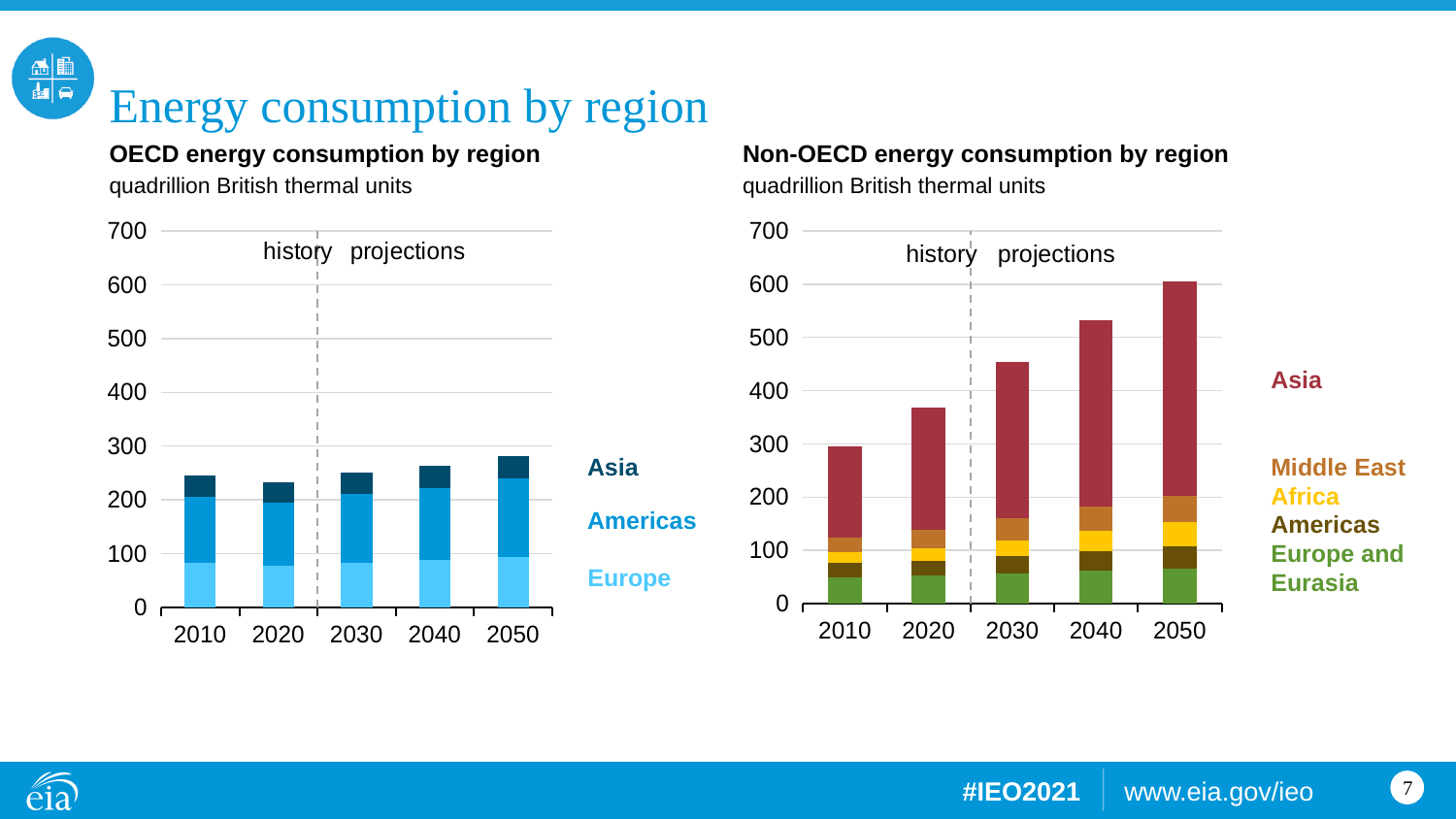
What unit is used on the y axis of both charts? quadrillion British thermal units In the OECD energy consumption by region chart, is the total for 2050 greater or less than 300? less What type of chart is the OECD energy consumption by region chart? stacked bar chart In the Non-OECD energy consumption by region chart, which year has the lowest total consumption? 2010 How many series does the legend of the OECD energy consumption by region chart list? 3 How many years are shown on the x axis of the Non-OECD energy consumption by region chart? 5 How many series does the legend of the Non-OECD energy consumption by region chart list? 5 In the Non-OECD energy consumption by region chart, which year has the highest total consumption? 2050 In the OECD energy consumption by region chart, which year has the highest total consumption? 2050 In the Non-OECD energy consumption by region chart, is the total for 2050 greater or less than 500? greater Which is larger in 2050: the total in the Non-OECD energy consumption by region chart or the total in the OECD energy consumption by region chart? Non-OECD In the Non-OECD energy consumption by region chart, do total values rise or fall from 2010 to 2050? rise